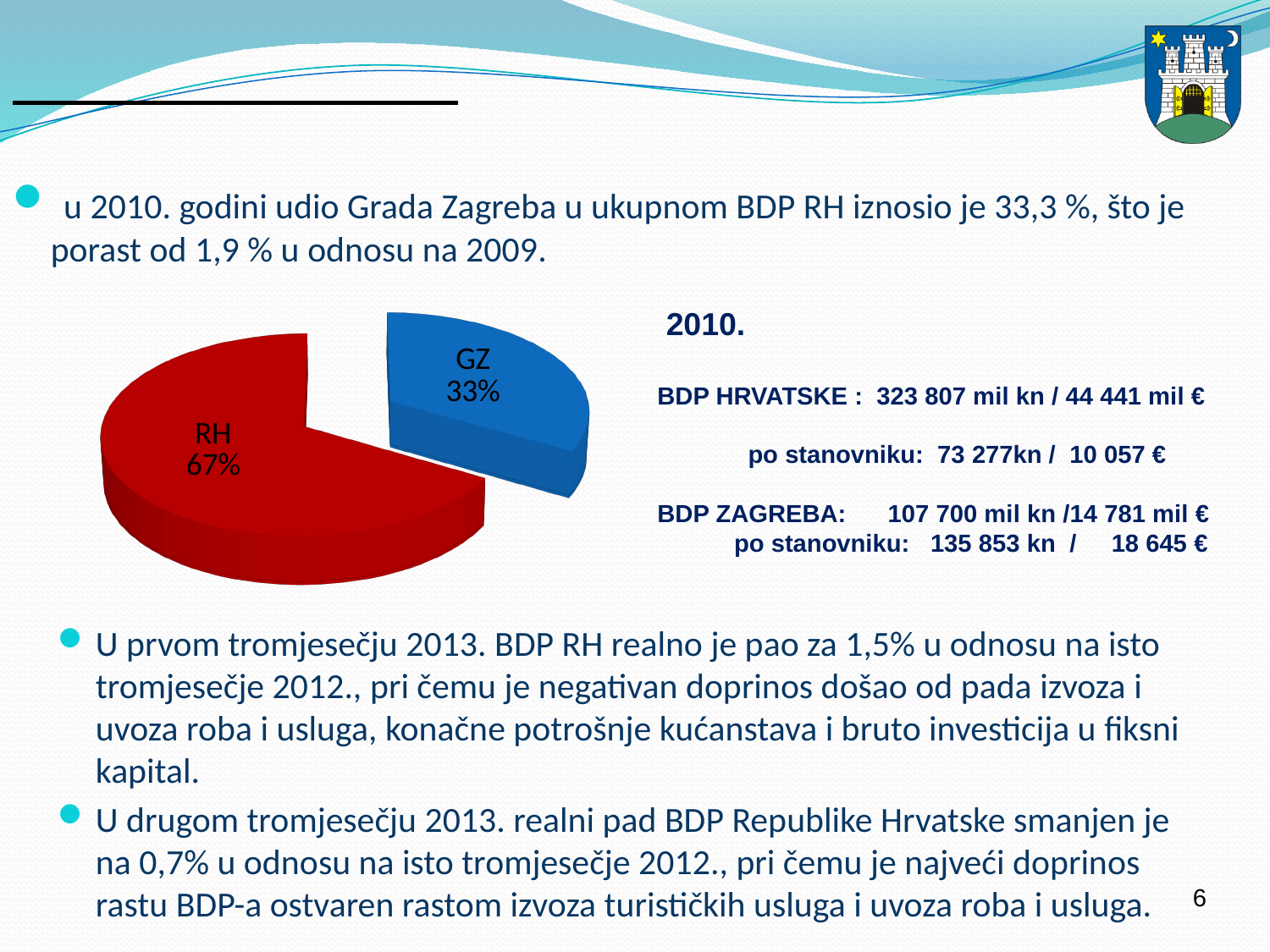
Which slice of the pie is the largest? RH What colour is the RH slice of the pie? red What share of the pie does the GZ slice represent? 33% What is the difference in percentage points between the RH slice and the GZ slice? 34 What is the total of the two slice percentages shown on the pie chart? 100% What kind of chart is shown on the slide? pie chart What colour is the GZ slice of the pie? blue Is the share of the GZ slice greater or less than 50%? less How many slices does the pie chart have? 2 Which slice of the pie is the smallest? GZ What share of the pie does the RH slice represent? 67% Which is larger, the RH slice or the GZ slice? RH